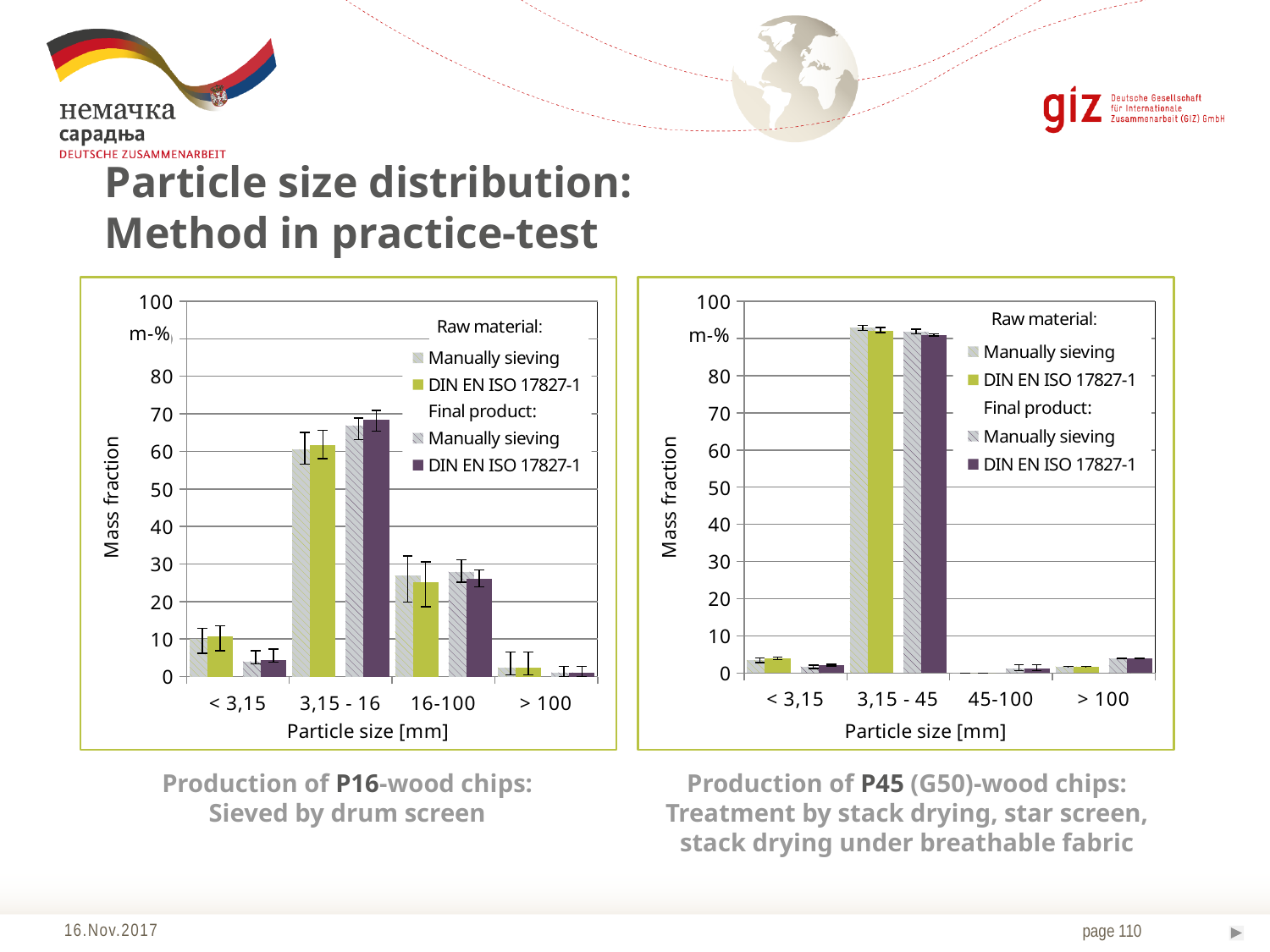
In the right chart (P45-wood chips), which category has the larger mass fraction for Raw material manually sieving: 3,15 - 45 or > 100? 3,15 - 45 In the right chart (P45-wood chips), is the Raw material DIN EN ISO 17827-1 value for < 3,15 greater or less than 10? less What is the y-axis title of the left chart (P16-wood chips)? Mass fraction In the right chart (P45-wood chips), how many series does the legend list? 4 In the left chart (P16-wood chips), how many particle size categories are shown on the x axis? 4 In the right chart (P45-wood chips), which particle size category has the highest mass fraction? 3,15 - 45 What type of chart is shown on the left of the slide (Production of P16-wood chips)? bar chart In the right chart (P45-wood chips), is the Raw material manually sieving value for 3,15 - 45 greater or less than 90? greater In the left chart (P16-wood chips), which particle size category has the highest mass fraction? 3,15 - 16 In the left chart (P16-wood chips), which particle size category has the lowest mass fraction? > 100 In the left chart (P16-wood chips), is the Final product DIN EN ISO 17827-1 value for 3,15 - 16 greater or less than 60? greater